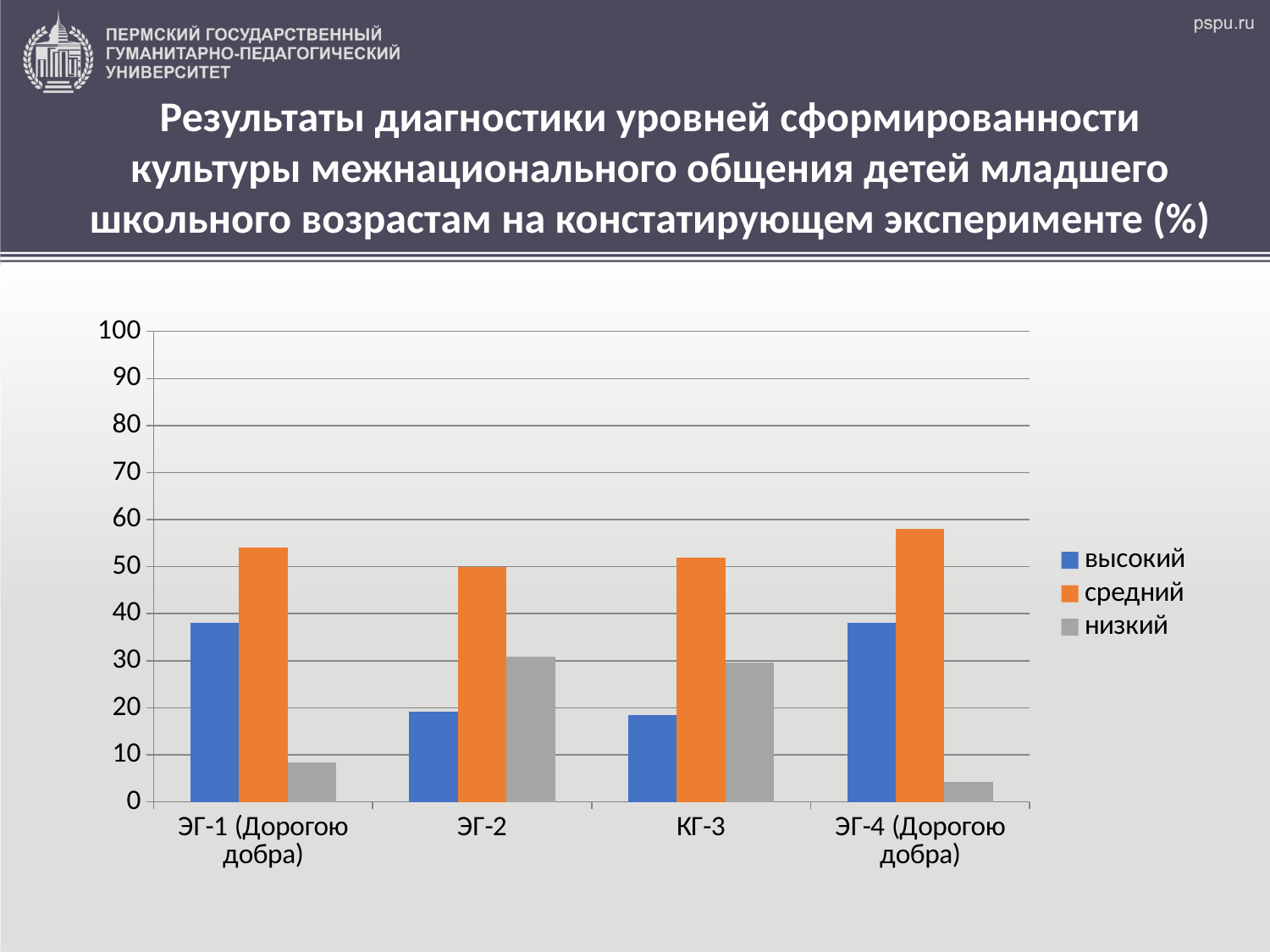
How many groups (categories) are shown on the x axis? 4 Which group has the larger низкий value: ЭГ-1 (Дорогою добра) or ЭГ-2? ЭГ-2 Is the высокий value for КГ-3 greater or less than 20? less What kind of chart is shown on the slide? bar chart What colour are the bars for the средний series? orange Is the средний value for ЭГ-1 (Дорогою добра) greater or less than 50? greater Which group has the lowest value for the низкий series? ЭГ-4 (Дорогою добра) How many series does the legend list? 3 Which group has the highest value for the средний series? ЭГ-4 (Дорогою добра) Which is larger for ЭГ-1 (Дорогою добра): the высокий value or the средний value? средний Is the низкий value for ЭГ-2 greater or less than 20? greater